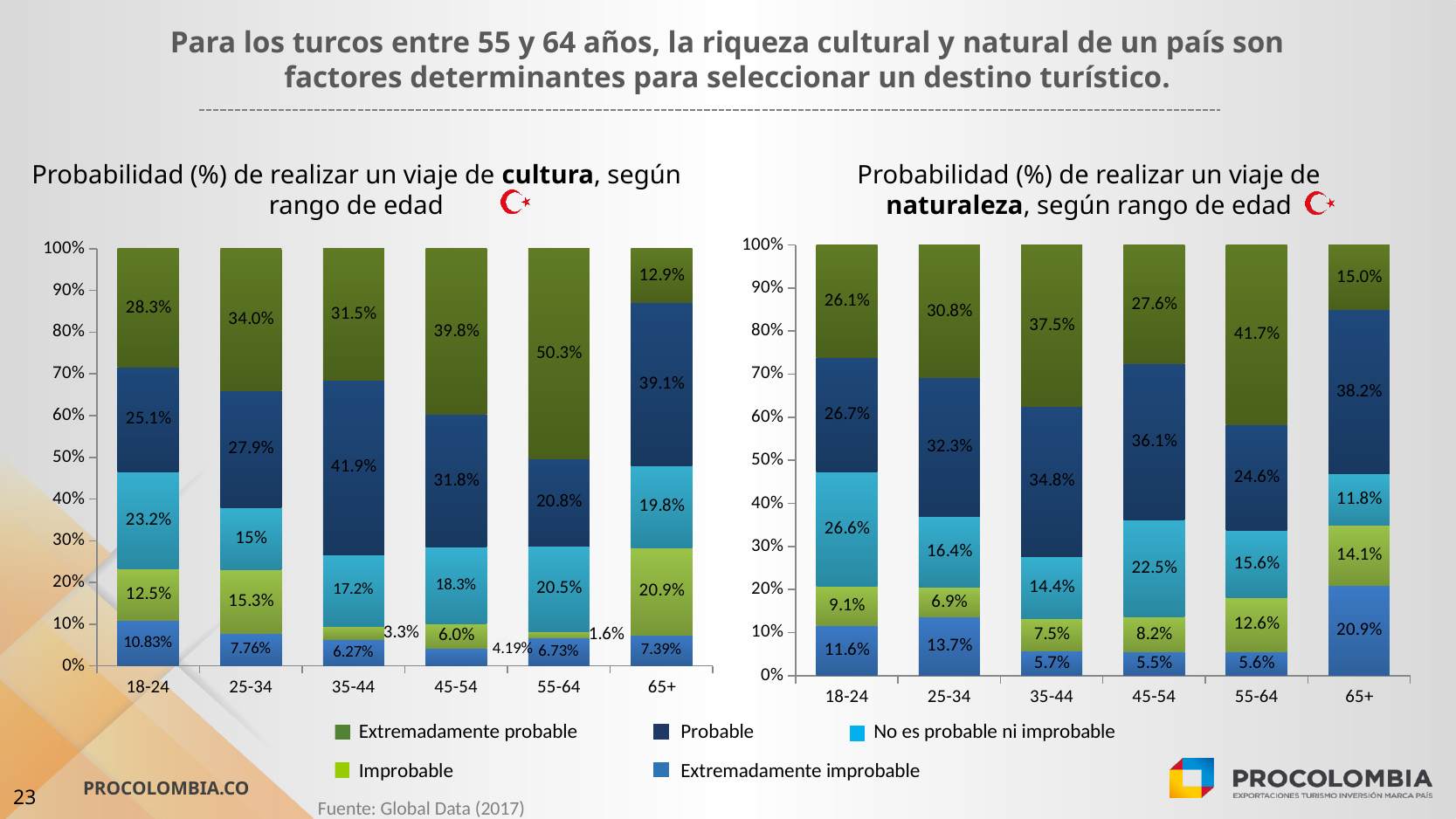
In the naturaleza chart (right), which age group has the lowest 'Extremadamente probable' share? 65+ In the cultura chart (left), which is larger for the 35-44 group: 'Probable' or 'Extremadamente probable'? Probable In the naturaleza chart (right), what is the 'Extremadamente improbable' value for the 65+ age group? 20.9% What type of chart is the naturaleza chart (right)? Stacked bar chart How many series does the legend list for the charts? 5 In the naturaleza chart (right), what is the difference between the 'Extremadamente probable' values for 55-64 and 18-24? 15.6% In the cultura chart (left), what is the 'Improbable' value for the 55-64 age group? 1.6% In the naturaleza chart (right), what is the 'Probable' value for the 45-54 age group? 36.1% In the cultura chart (left), what is the 'Extremadamente probable' value for the 55-64 age group? 50.3% In the cultura chart (left), which age group has the highest 'Extremadamente probable' share? 55-64 What is the source cited at the bottom of the slide? Global Data (2017) How many age groups are shown on the x axis of the cultura chart (left)? 6